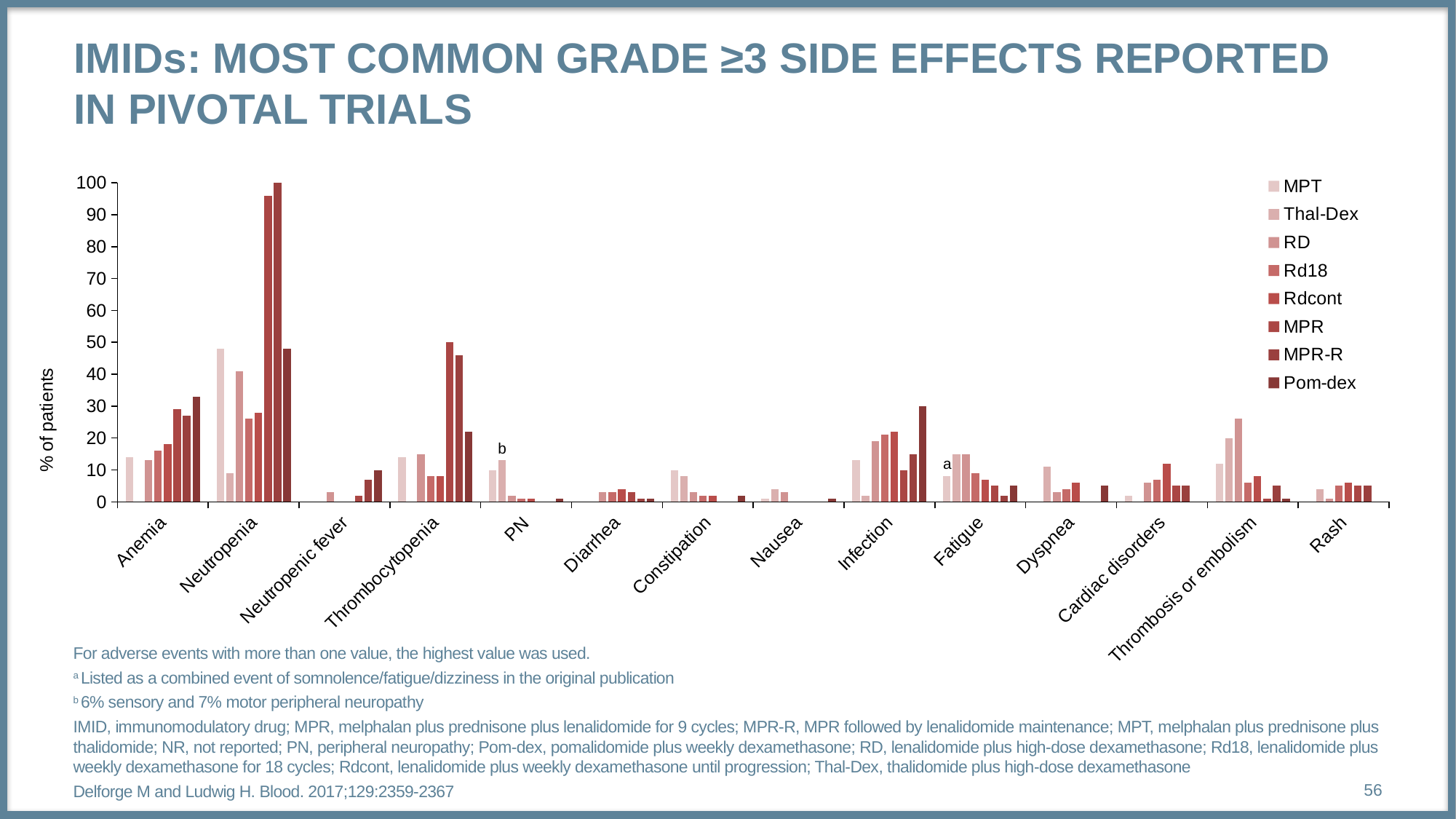
Which is larger for Pom-dex: the value for Infection or the value for Fatigue? Infection What is the label on the y axis of the chart? % of patients Is the Pom-dex value for Anemia greater or less than 30? greater What kind of chart is shown on the slide? bar chart Is the Thal-Dex value for Fatigue greater or less than 10? greater How many series does the legend list? 8 Which is larger for MPT: the value for Anemia or the value for Neutropenia? Neutropenia How many side-effect categories are shown along the x axis? 14 Which side-effect category contains the tallest bar in the chart? Neutropenia Is the MPT value for Neutropenia greater or less than 40? greater